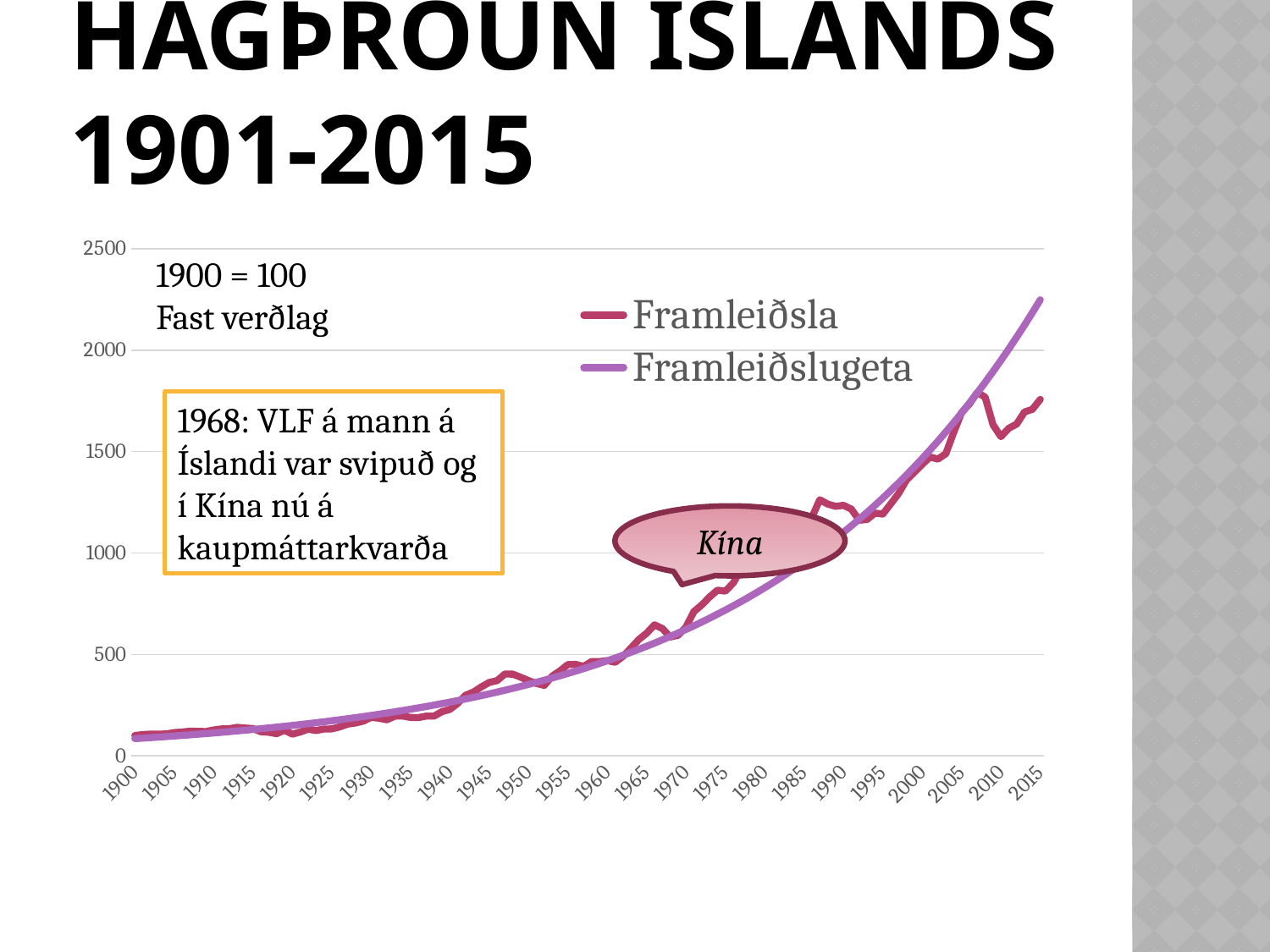
Is the value for Framleiðslugeta in 2015 greater or less than 2000? greater What kind of chart is shown on the slide? line chart Is the value for Framleiðsla in 1900 greater or less than 500? less Is the value for Framleiðsla in 2015 greater or less than 2000? less How many series does the legend list? 2 How many year labels are shown on the x axis? 24 Do the values for Framleiðslugeta rise or fall from 1900 to 2015? rise What base-year note is printed in the top-left of the chart area? 1900 = 100 In 2015, which series has the higher value, Framleiðsla or Framleiðslugeta? Framleiðslugeta What are the two series named in the legend? Framleiðsla and Framleiðslugeta